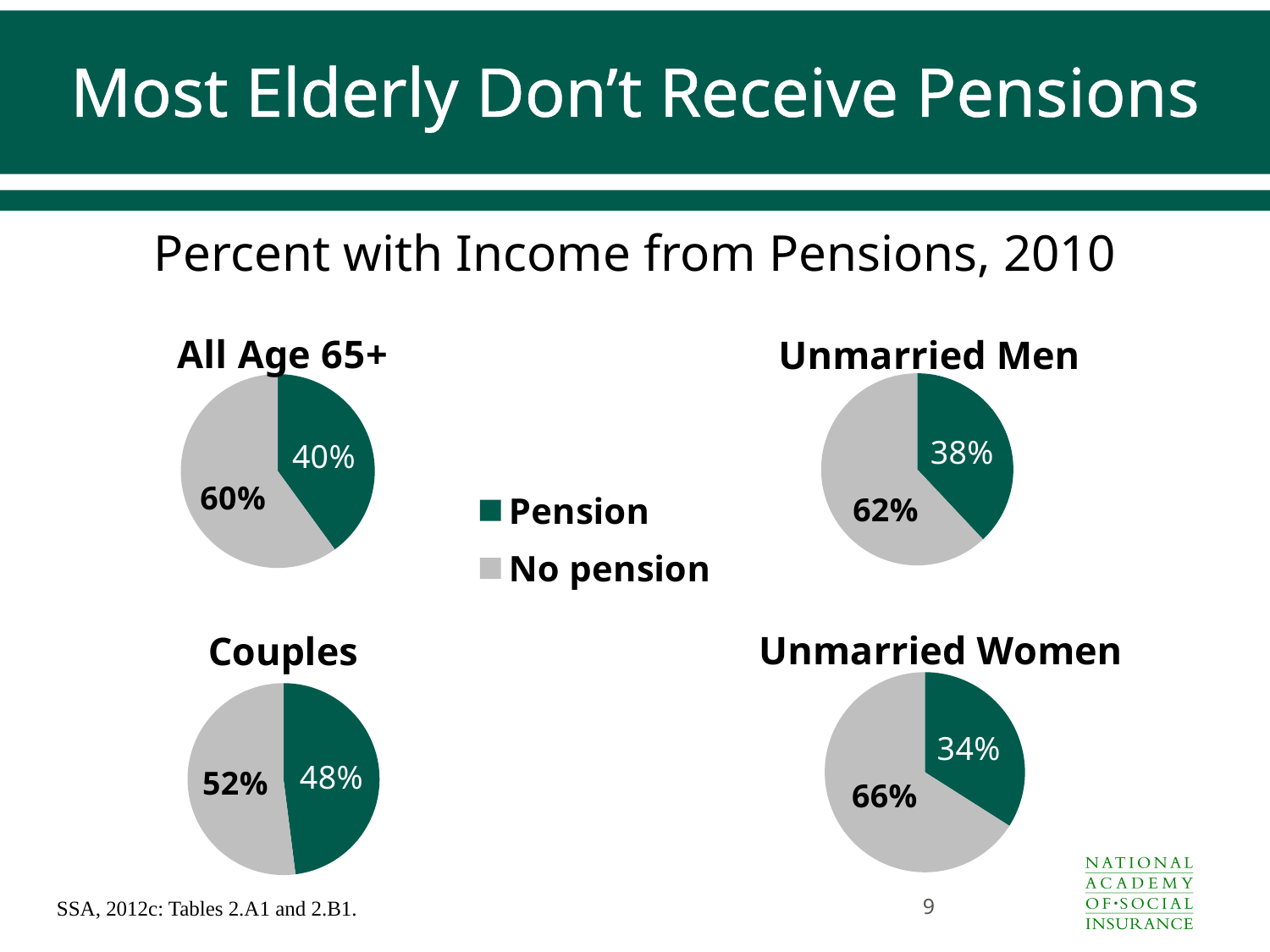
What kind of chart is used for each of the four groups on the slide? Pie chart How many pie charts are shown on the slide? 4 Across the four pie charts, which group has the highest share with a pension? Couples How many entries does the legend list? 2 In the 'Couples' pie chart, what is the difference between the 'No pension' and 'Pension' shares? 4% Is the 'Pension' share larger for Unmarried Men or for Unmarried Women? Unmarried Men Which colour represents 'No pension' in the pie charts? Gray In the 'Unmarried Men' pie chart, what percent have no pension? 62% In the 'All Age 65+' pie chart, what percent have a pension? 40% In the 'Couples' pie chart, what percent have a pension? 48% Across the four pie charts, which group has the lowest share with a pension? Unmarried Women In the 'Unmarried Women' pie chart, what percent have no pension? 66%